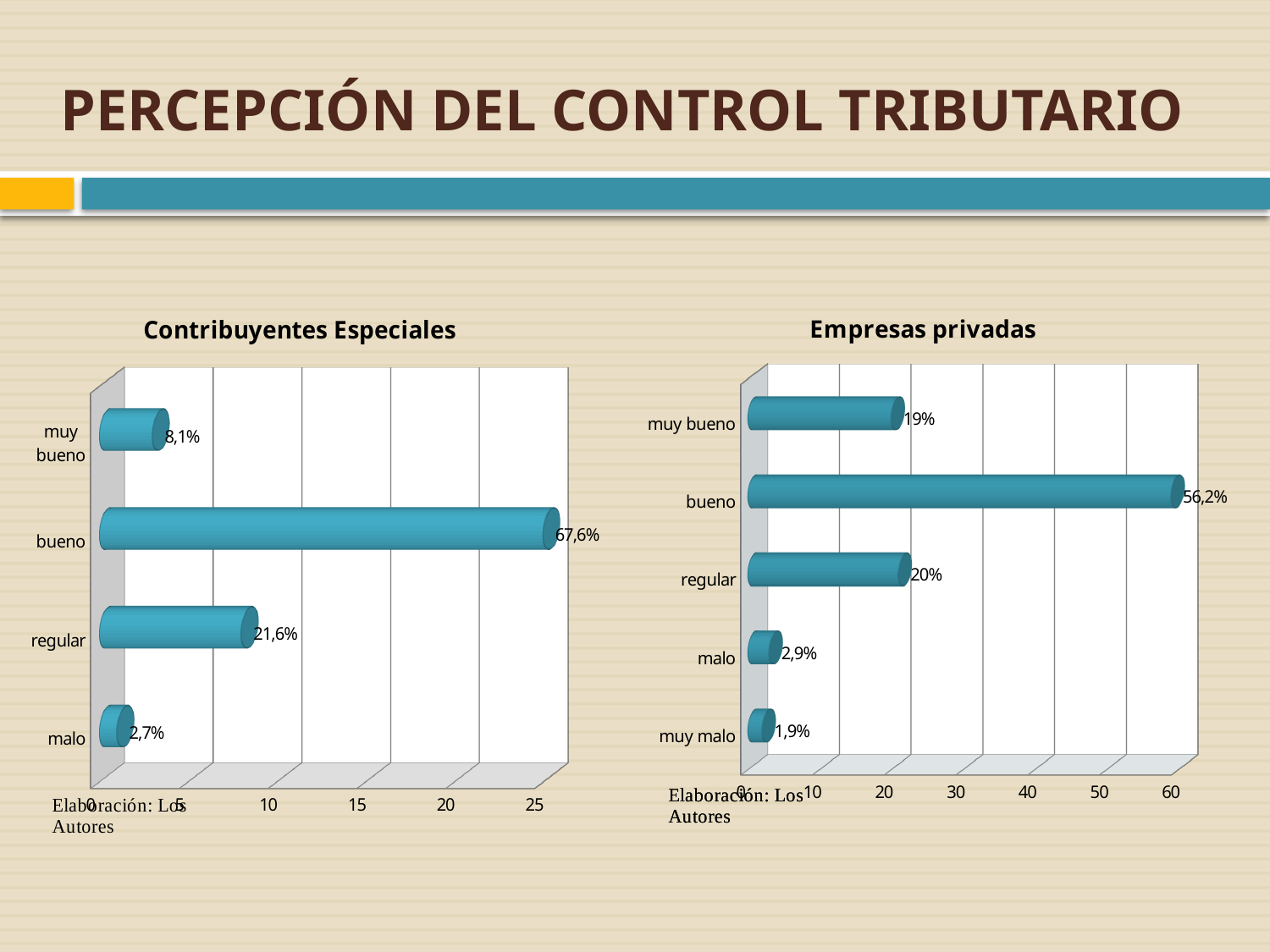
In the Empresas privadas chart, what is the difference between the values for bueno and regular? 36,2% In the Contribuyentes Especiales chart, what is the value for regular? 21,6% How many categories does the Contribuyentes Especiales chart show? 4 How many categories does the Empresas privadas chart show? 5 In the Contribuyentes Especiales chart, what is the value for bueno? 67,6% What kind of chart is the Empresas privadas chart? bar chart In the Contribuyentes Especiales chart, which category has the highest value? bueno In the Contribuyentes Especiales chart, which is larger, the value for muy bueno or the value for regular? regular In the Empresas privadas chart, what is the value for muy bueno? 19% In the Empresas privadas chart, what is the value for muy malo? 1,9% In the Empresas privadas chart, which category has the lowest value? muy malo In the Contribuyentes Especiales chart, which category has the lowest value? malo